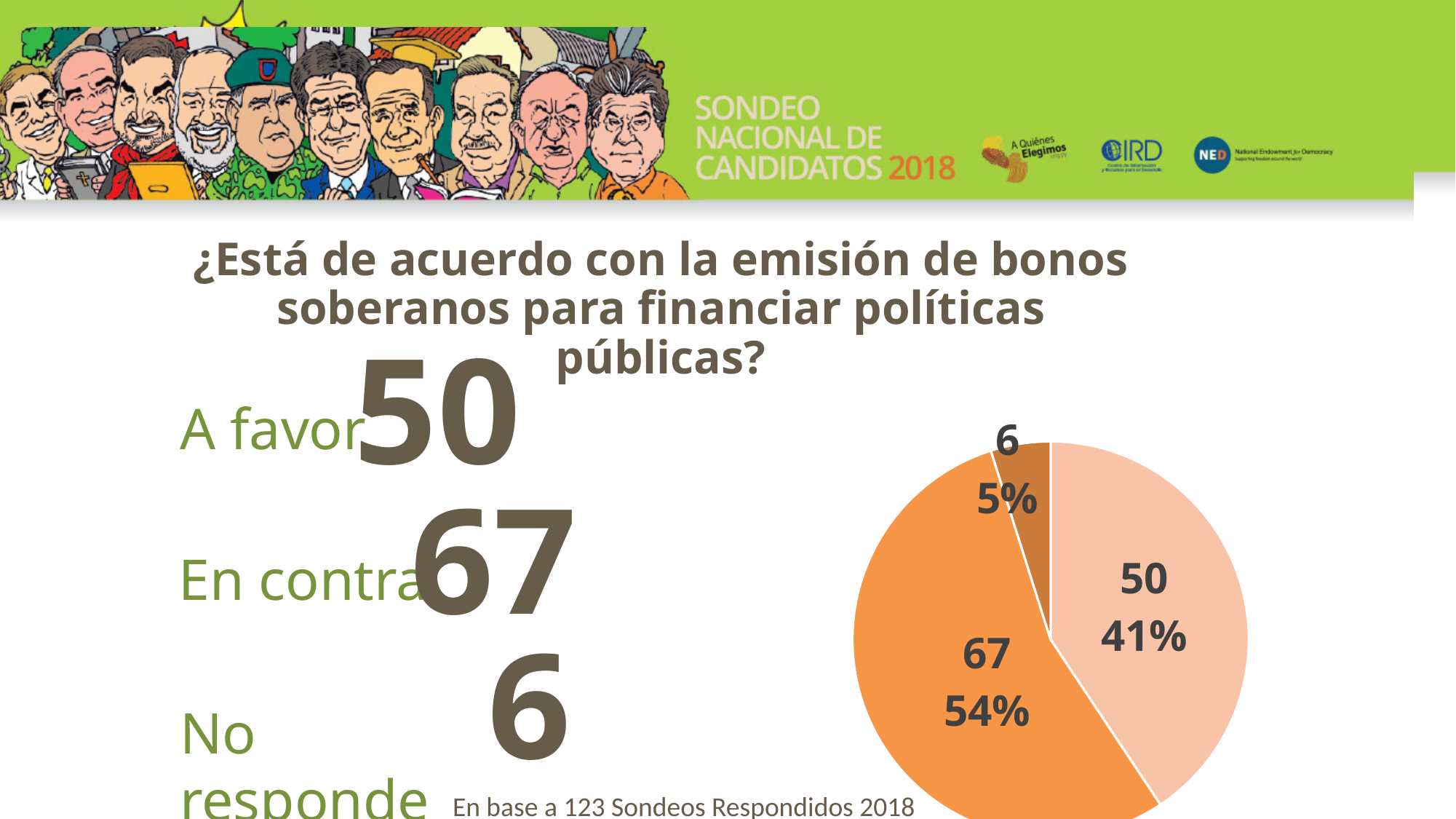
What percentage share does the slice labelled 50 have in the pie chart? 41% What is the difference between the 'En contra' count and the 'A favor' count? 17 How many slices does the pie chart have? 3 Which is larger, the 'A favor' count or the 'No responde' count? A favor What kind of chart is shown on the slide? pie chart What percentage share does the slice labelled 67 have in the pie chart? 54% How many respondents answered 'A favor' according to the slide? 50 What is the count shown for the smallest slice of the pie chart? 6 What percentage share does the slice labelled 6 have in the pie chart? 5% How many respondents answered 'En contra' according to the slide? 67 What is the count shown for the largest slice of the pie chart? 67 How many surveys is the chart based on, according to the note at the bottom of the slide? 123